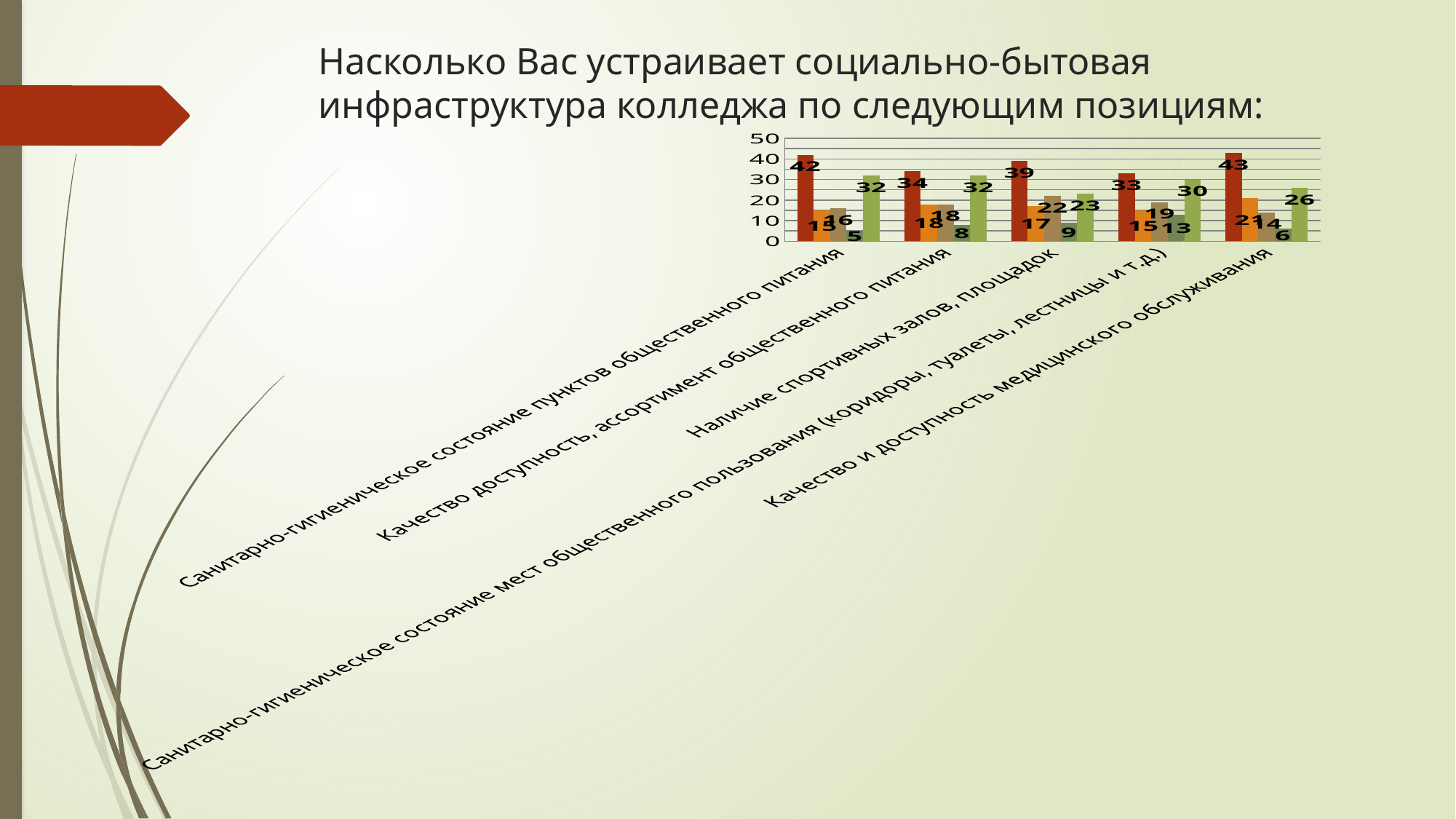
For "Наличие спортивных залов, площадок", which is larger: the tan bar or the light green bar? the light green bar What is the value of the dark red bar for "Наличие спортивных залов, площадок"? 39 What kind of chart is shown on the slide? bar chart Which category has the highest dark red bar? Качество и доступность медицинского обслуживания Which category has the lowest dark green bar? Санитарно-гигиеническое состояние пунктов общественного питания What is the value of the dark red bar for "Качество и доступность медицинского обслуживания"? 43 How many categories are shown on the x axis of the chart? 5 What is the highest value shown on the vertical axis of the chart? 50 What is the value of the light green bar for "Санитарно-гигиеническое состояние пунктов общественного питания"? 32 Is the dark red bar for "Санитарно-гигиеническое состояние мест общественного пользования (коридоры, туалеты, лестницы и т.д.)" greater or less than 30? greater What is the difference between the dark red bar (42) and the light green bar (32) for "Санитарно-гигиеническое состояние пунктов общественного питания"? 10 What is the value of the dark green bar for "Качество доступность, ассортимент общественного питания"? 8